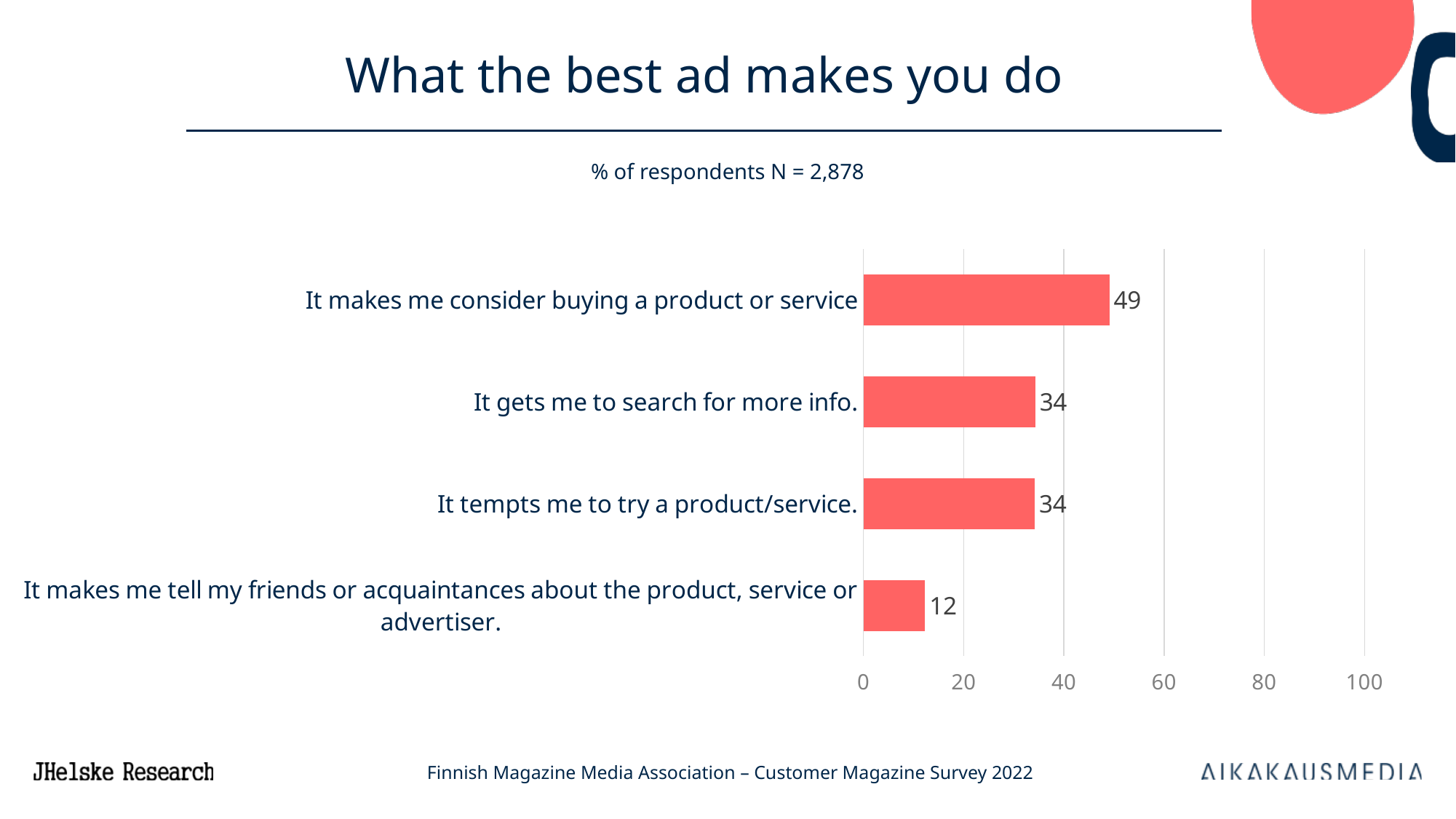
What is the difference between the value for "It makes me consider buying a product or service" and the value for "It tempts me to try a product/service."? 15 Which is larger: the value for "It makes me consider buying a product or service" or the value for "It gets me to search for more info."? It makes me consider buying a product or service Which category has the lowest value? It makes me tell my friends or acquaintances about the product, service or advertiser. What percentage of respondents say the best ad makes them consider buying a product or service? 49 What is the title of the slide? What the best ad makes you do What is the value for "It gets me to search for more info."? 34 What kind of chart is shown on the slide? Bar chart Which category has the highest value? It makes me consider buying a product or service Is the value for "It makes me consider buying a product or service" greater or less than 40? greater What is the value for "It makes me tell my friends or acquaintances about the product, service or advertiser."? 12 What is the difference between the value for "It gets me to search for more info." and the value for "It makes me tell my friends or acquaintances about the product, service or advertiser."? 22 How many categories are shown in the chart? 4